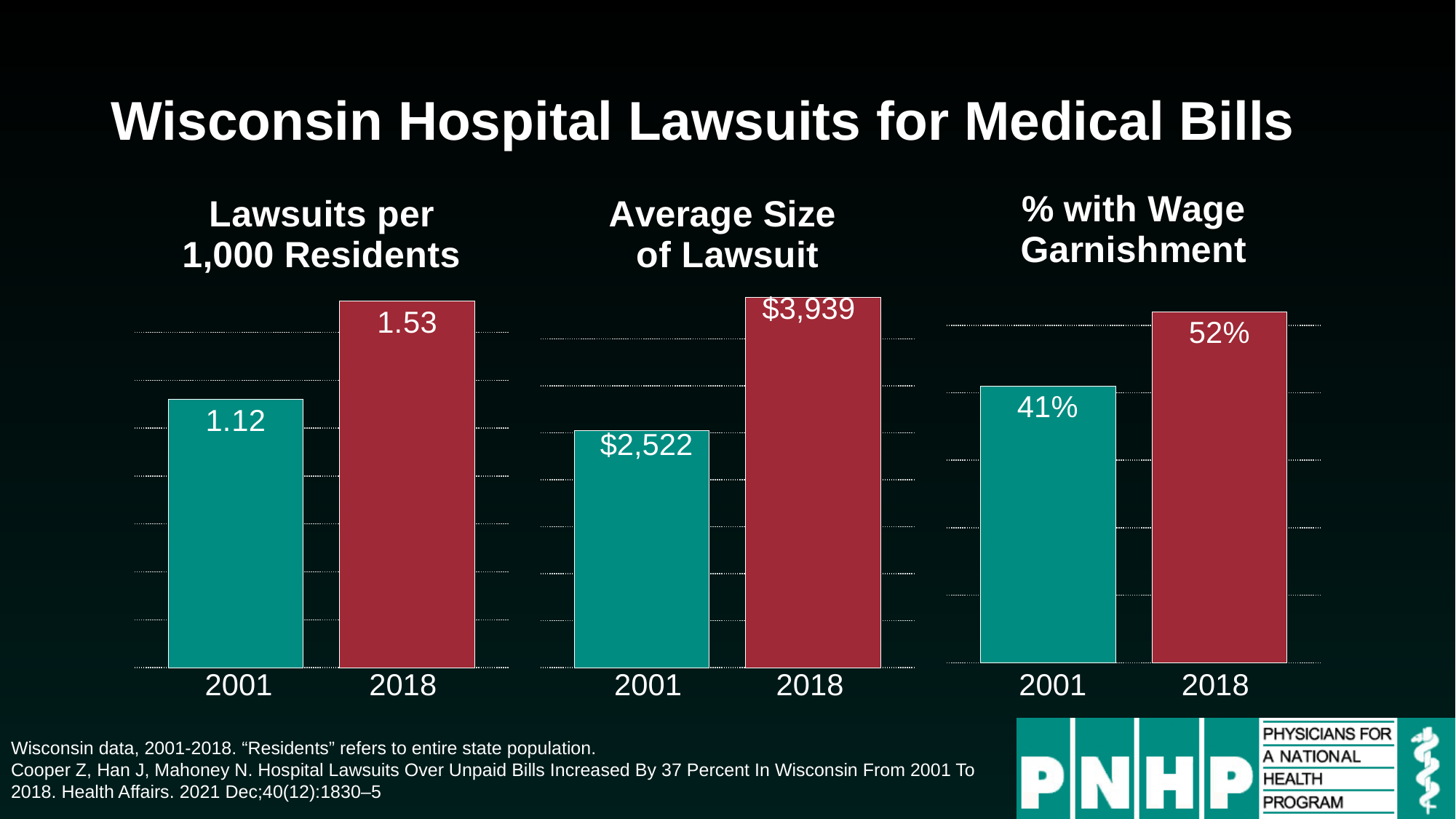
In the 'Average Size of Lawsuit' chart, what is the value for 2018? $3,939 In the 'Average Size of Lawsuit' chart, what is the value for 2001? $2,522 In the '% with Wage Garnishment' chart, what is the value for 2001? 41% In the 'Lawsuits per 1,000 Residents' chart, which year has the higher value? 2018 How many separate charts are shown on the slide? 3 In the '% with Wage Garnishment' chart, by how many percentage points did the value increase from 2001 to 2018? 11 In the 'Lawsuits per 1,000 Residents' chart, what is the value for 2001? 1.12 How many bars are in the '% with Wage Garnishment' chart? 2 In the 'Average Size of Lawsuit' chart, what is the difference between the 2018 and 2001 values? $1,417 What kind of chart is the 'Average Size of Lawsuit' chart? Bar chart In the 'Lawsuits per 1,000 Residents' chart, what is the value for 2018? 1.53 In the '% with Wage Garnishment' chart, what is the value for 2018? 52%